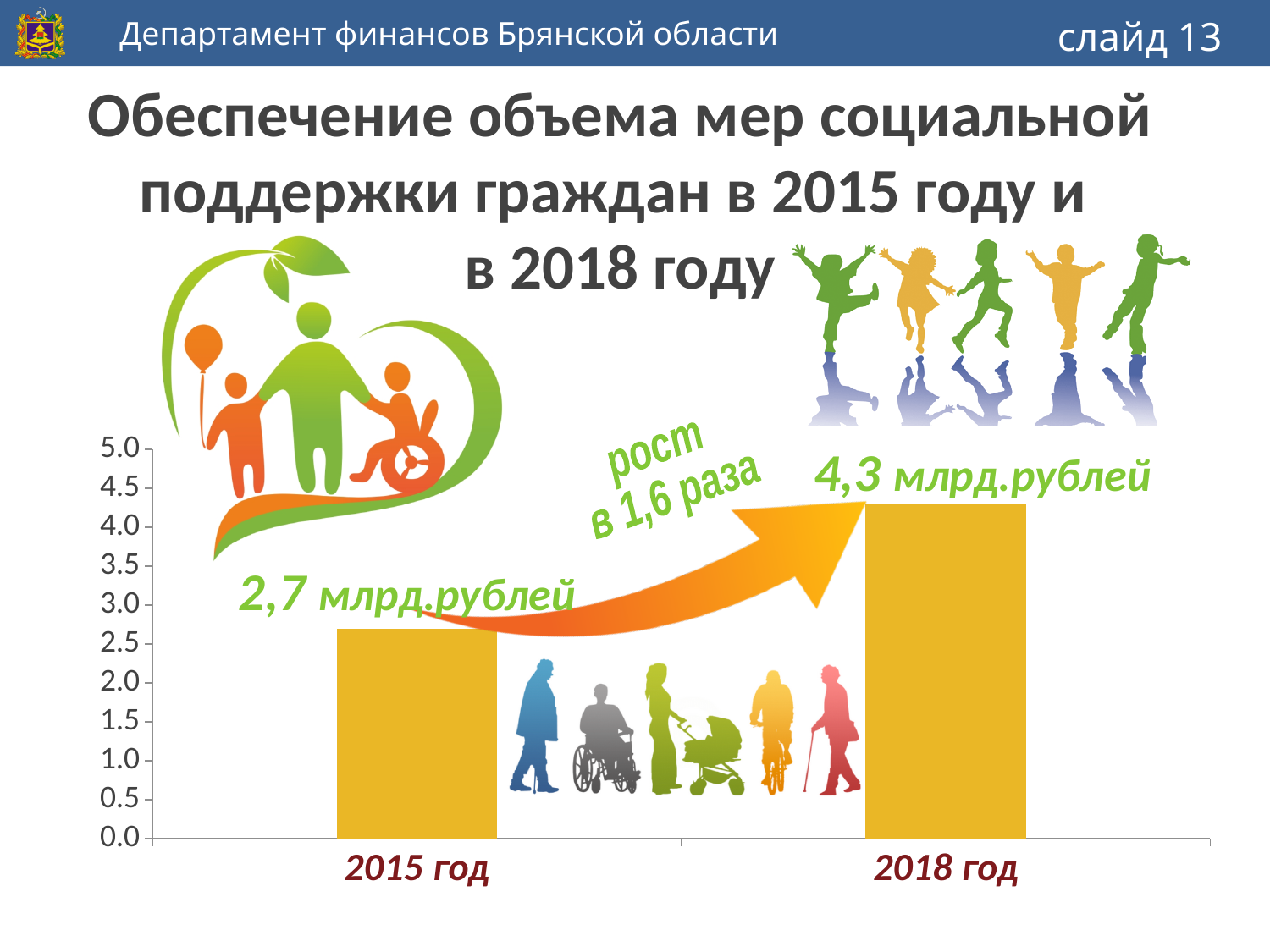
What kind of chart is shown on the slide? bar chart Which category has the lowest value on the chart? 2015 год Is the value for 2018 год greater or less than 4.0? greater Is the value for 2015 год greater or less than 3.0? less Which category has the highest value on the chart? 2018 год How many categories are plotted on the chart? 2 By what factor does the chart annotation say the value grew from 2015 to 2018? в 1,6 раза Do the values rise or fall from 2015 год to 2018 год? rise What is the value shown for 2015 год? 2,7 млрд.рублей What is the difference between the values for 2018 год and 2015 год? 1,6 млрд.рублей What is the value shown for 2018 год? 4,3 млрд.рублей Which year has the higher value, 2015 год or 2018 год? 2018 год